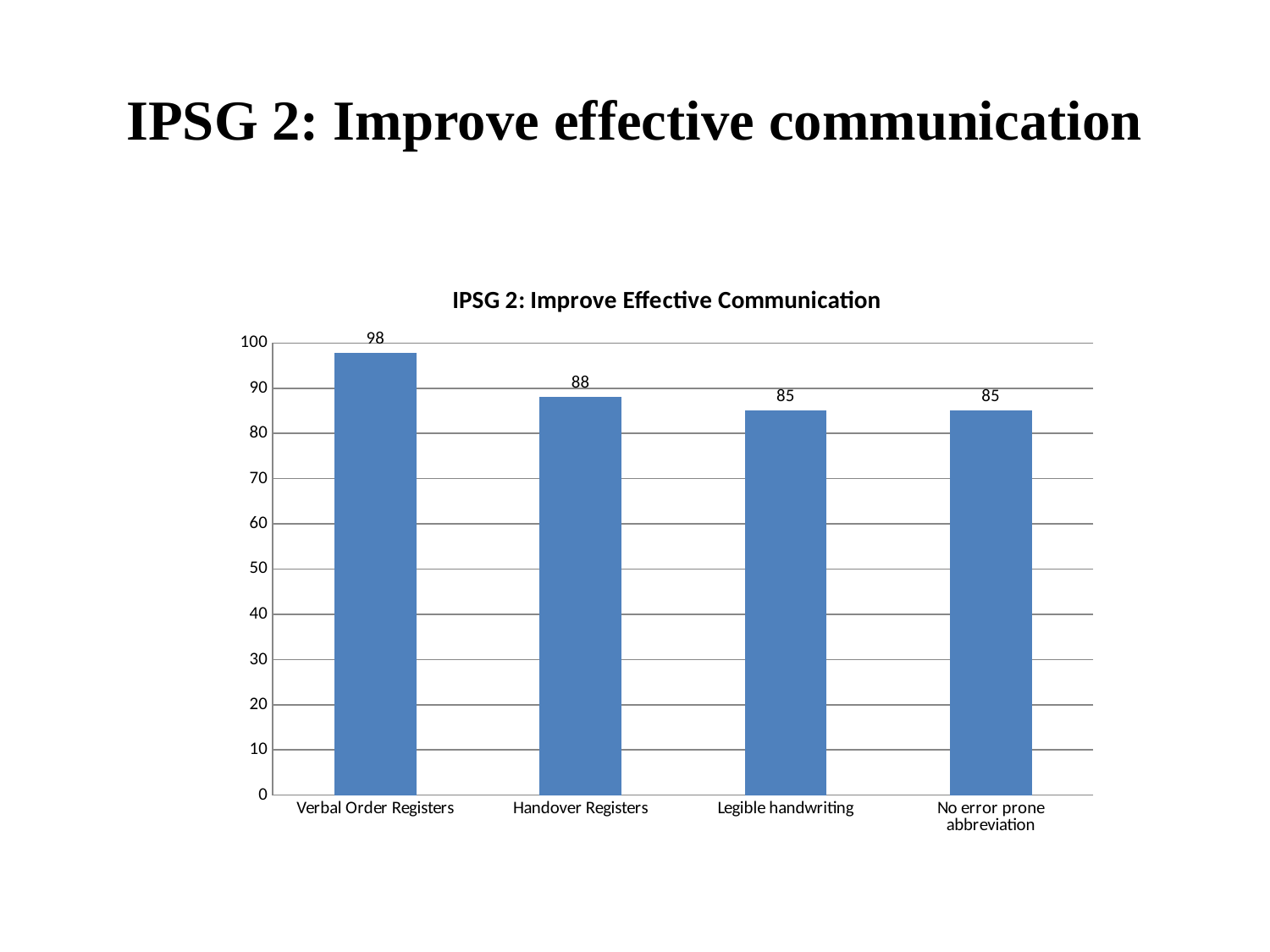
Is the value for Handover Registers greater or less than 80? greater What is the value for Legible handwriting? 85 Which is larger, the value for Verbal Order Registers or the value for Legible handwriting? Verbal Order Registers What kind of chart is shown on the slide? bar chart What is the value for Verbal Order Registers? 98 Which category has the highest value? Verbal Order Registers What is the difference between the values for Handover Registers and Legible handwriting? 3 What is the value for Handover Registers? 88 What is the title of the chart? IPSG 2: Improve Effective Communication How many categories are shown on the x axis? 4 What is the value for No error prone abbreviation? 85 What is the difference between the values for Verbal Order Registers and Handover Registers? 10